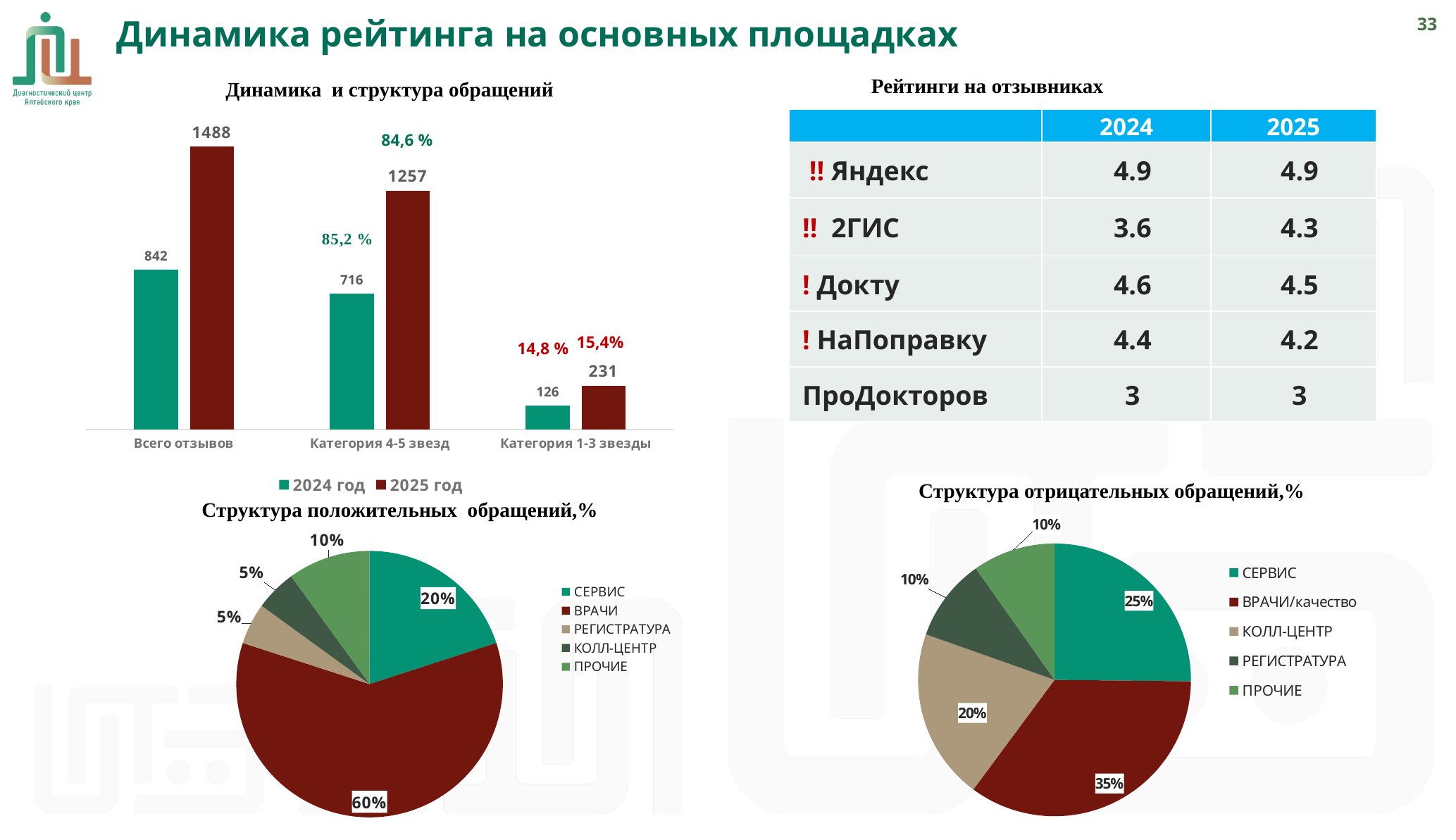
In the chart 'Динамика и структура обращений', what is the value for 'Всего отзывов' in the '2025 год' series? 1488 In the chart 'Динамика и структура обращений', how many series does the legend list? 2 In the chart 'Структура отрицательных обращений,%', which category has the largest share? ВРАЧИ/качество In the chart 'Структура положительных обращений,%', what share does 'ВРАЧИ' have? 60% What type of chart is 'Динамика и структура обращений'? bar chart In the chart 'Структура положительных обращений,%', which category has the smallest share, 'СЕРВИС' or 'ПРОЧИЕ'? ПРОЧИЕ In the chart 'Структура отрицательных обращений,%', how many categories does the legend list? 5 In the chart 'Структура отрицательных обращений,%', what share does 'КОЛЛ-ЦЕНТР' have? 20% In the chart 'Динамика и структура обращений', how many categories are shown on the x axis? 3 In the chart 'Динамика и структура обращений', what is the difference between the 2025 and 2024 values for 'Всего отзывов'? 646 In the chart 'Динамика и структура обращений', what is the value for 'Категория 4-5 звезд' in the '2024 год' series? 716 In the chart 'Динамика и структура обращений', which category has the lowest value in the '2024 год' series? Категория 1-3 звезды